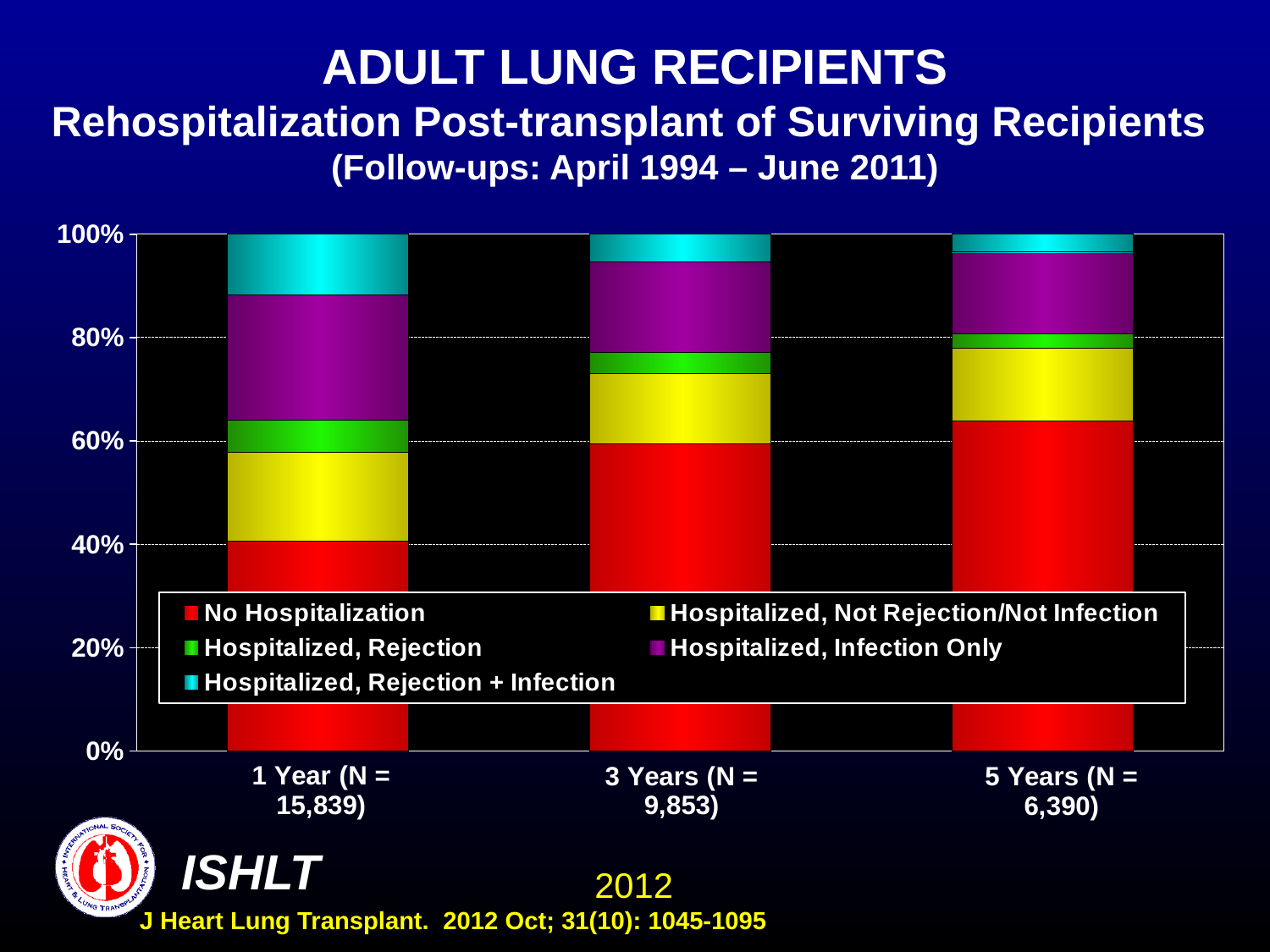
How many series does the legend list? 5 What kind of chart is shown on the slide? Stacked bar chart How many follow-up time points (bars) are shown on the x axis? 3 Is the No Hospitalization share for 5 Years greater or less than 40%? greater Which follow-up time point has the largest Hospitalized, Rejection + Infection share? 1 Year (N = 15,839) Does the No Hospitalization share rise or fall from 1 Year to 5 Years? rise Is the No Hospitalization share for 1 Year greater or less than 60%? less What is the N shown for the 1 Year category? 15,839 What is the N shown for the 3 Years category? 9,853 Which follow-up time point has the largest No Hospitalization share? 5 Years (N = 6,390) What colour represents No Hospitalization in the legend? Red Does the Hospitalized, Rejection + Infection share rise or fall from 1 Year to 5 Years? fall